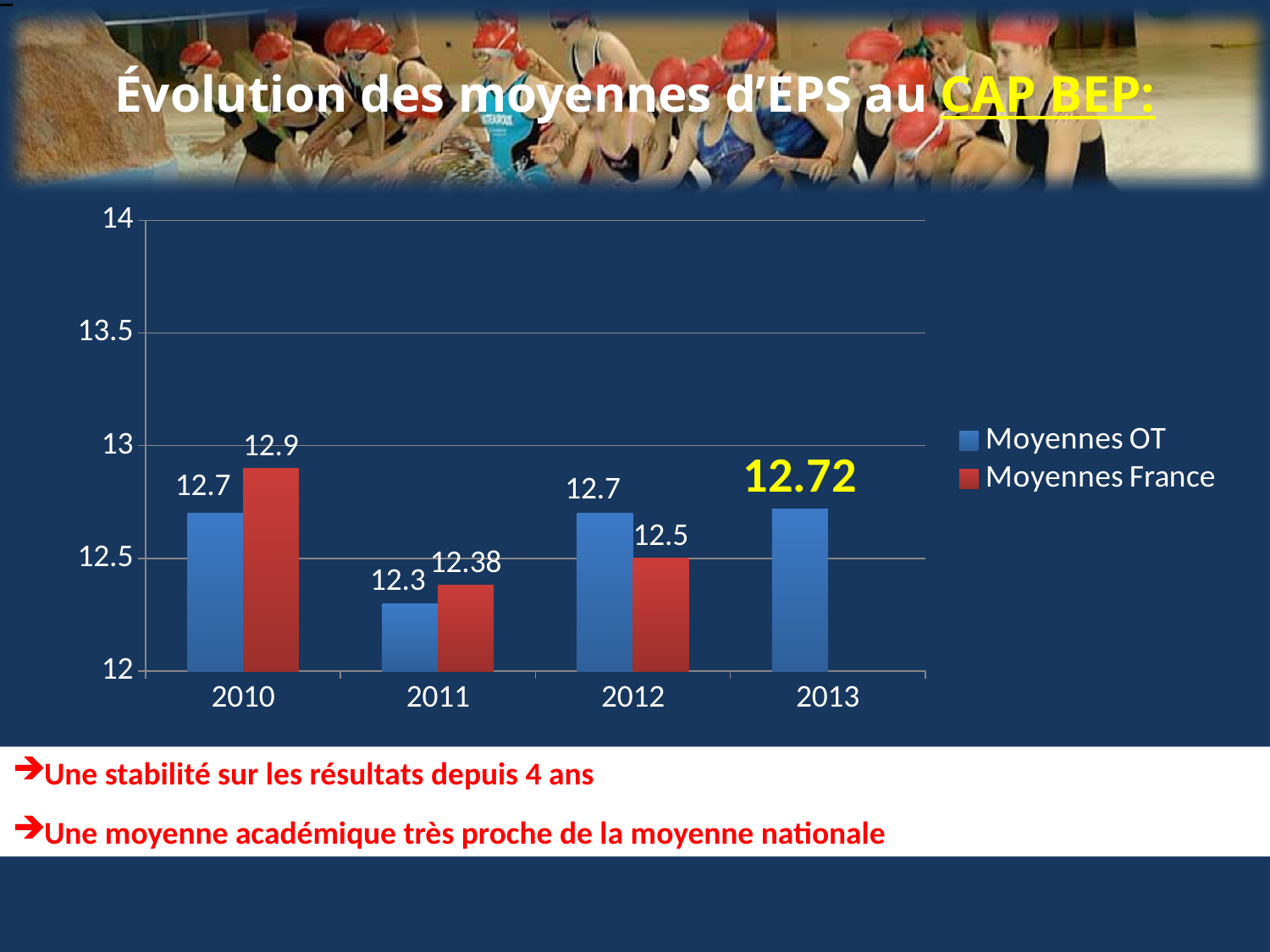
In which year is Moyennes France the highest? 2010 In which year is Moyennes OT the lowest? 2011 Is the value of Moyennes OT for 2011 greater or less than 12.5? less How many years are shown on the x axis? 4 What is the difference between Moyennes France and Moyennes OT in 2010? 0.2 What is the value of Moyennes France for 2011? 12.38 In 2012, which is larger: Moyennes OT or Moyennes France? Moyennes OT What is the value of Moyennes OT for 2011? 12.3 How many series does the legend list? 2 What is the value of Moyennes OT for 2013? 12.72 What kind of chart is shown on the slide? bar chart What is the value of Moyennes France for 2010? 12.9